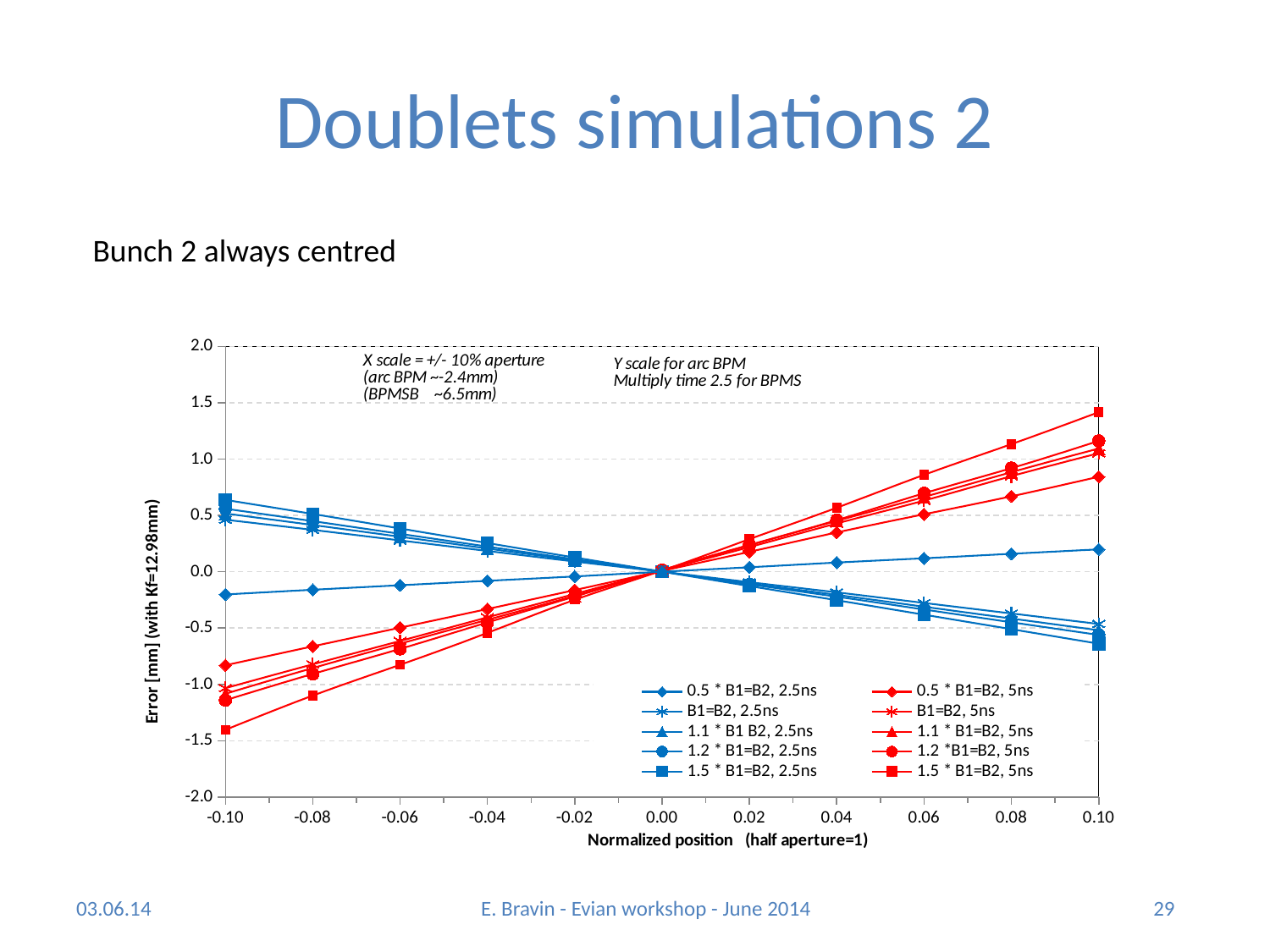
Is the error for '1.5 * B1=B2, 5ns' at normalized position 0.10 greater or less than 1.0? greater How many series does the legend list? 10 What is the title of the y axis? Error [mm] (with Kf=12.98mm) Which series has the highest error at normalized position 0.10? 1.5 * B1=B2, 5ns Does the error for the '1.5 * B1=B2, 2.5ns' series rise or fall as the normalized position increases? fall Is the error for '0.5 * B1=B2, 2.5ns' at normalized position 0.10 greater or less than 0.5? less Does the error for the '0.5 * B1=B2, 5ns' series rise or fall as the normalized position increases? rise At normalized position 0.10, which has the larger error: '1.5 * B1=B2, 5ns' or '0.5 * B1=B2, 5ns'? 1.5 * B1=B2, 5ns Which series has the lowest error at normalized position -0.10? 1.5 * B1=B2, 5ns What kind of chart is shown on the slide? line chart How many data points does each series have along the x axis? 11